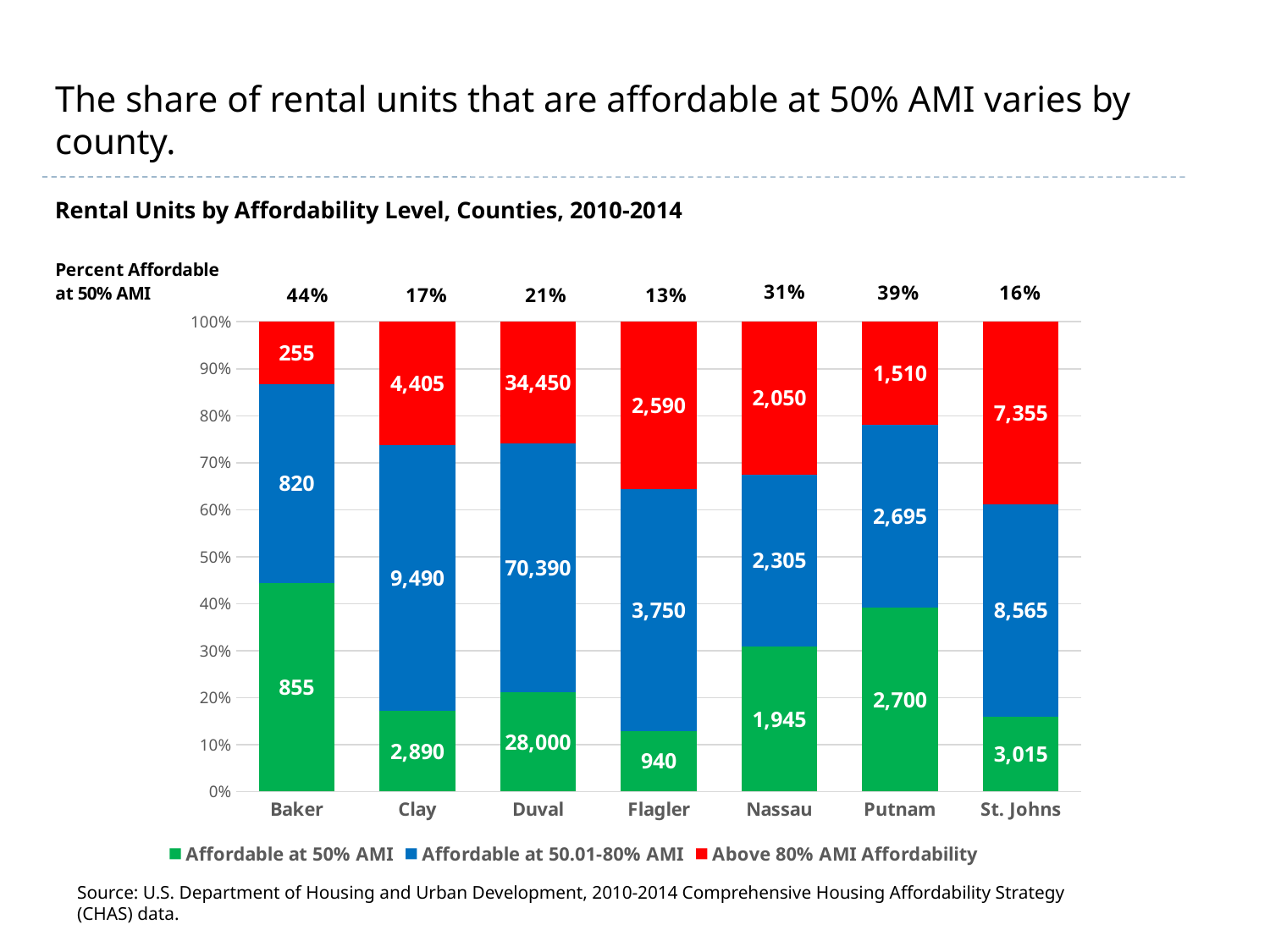
What is the total number of rental units shown for Flagler across all three affordability levels? 7,280 How many series does the chart legend list? 3 How many rental units in Duval are affordable at 50% AMI? 28,000 How many counties are shown on the x axis of the chart? 7 Which county has the lowest percent of rental units affordable at 50% AMI? Flagler Which county has the highest percent of rental units affordable at 50% AMI? Baker What is the total number of rental units shown for Baker across all three affordability levels? 1,930 What is the number of units in the 'Above 80% AMI Affordability' category for St. Johns? 7,355 Which is larger in Nassau: the number of units affordable at 50.01-80% AMI or the number above 80% AMI affordability? Affordable at 50.01-80% AMI What is the difference between the number of units affordable at 50.01-80% AMI and the number affordable at 50% AMI in Duval? 42,390 What percent of rental units in Putnam are affordable at 50% AMI, as shown above the bar? 39% What type of chart is used to show rental units by affordability level? Stacked bar chart